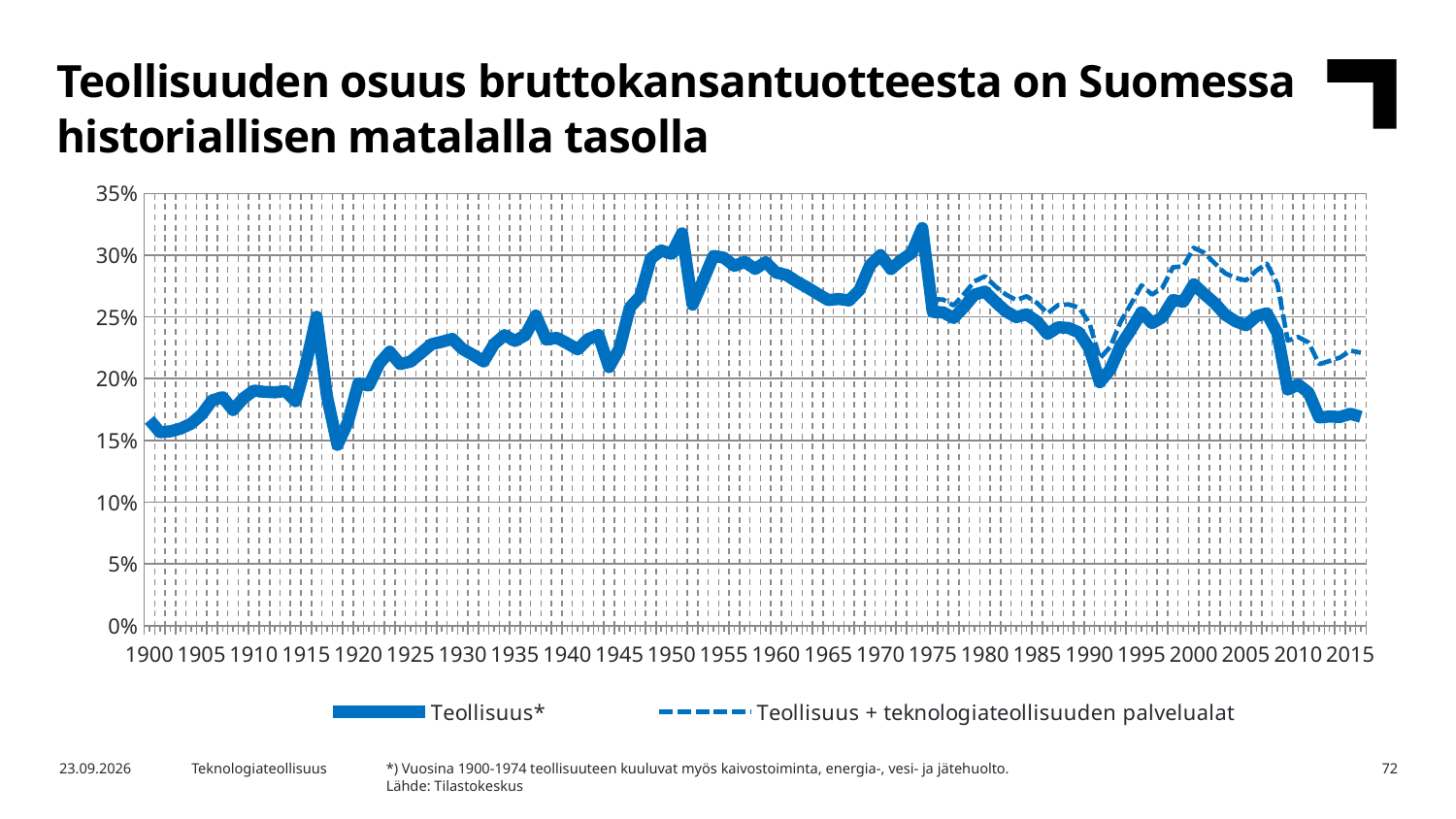
Is the value of Teollisuus* in 1950 greater or less than 25%? greater Is the value of Teollisuus + teknologiateollisuuden palvelualat in 2015 greater or less than 20%? greater What is the title of the chart on the slide? Teollisuuden osuus bruttokansantuotteesta on Suomessa historiallisen matalalla tasolla Is the value of Teollisuus* in 2015 greater or less than 20%? less In 2010, which series has the higher value: Teollisuus* or Teollisuus + teknologiateollisuuden palvelualat? Teollisuus + teknologiateollisuuden palvelualat How many series does the legend list? 2 Does the Teollisuus* series rise or fall between 2000 and 2015? fall What kind of chart is shown on the slide? line chart Does the Teollisuus* series rise or fall between 1900 and 1915? rise Which is larger for Teollisuus*: the value in 1950 or the value in 2015? 1950 Which series is drawn with a dashed line? Teollisuus + teknologiateollisuuden palvelualat